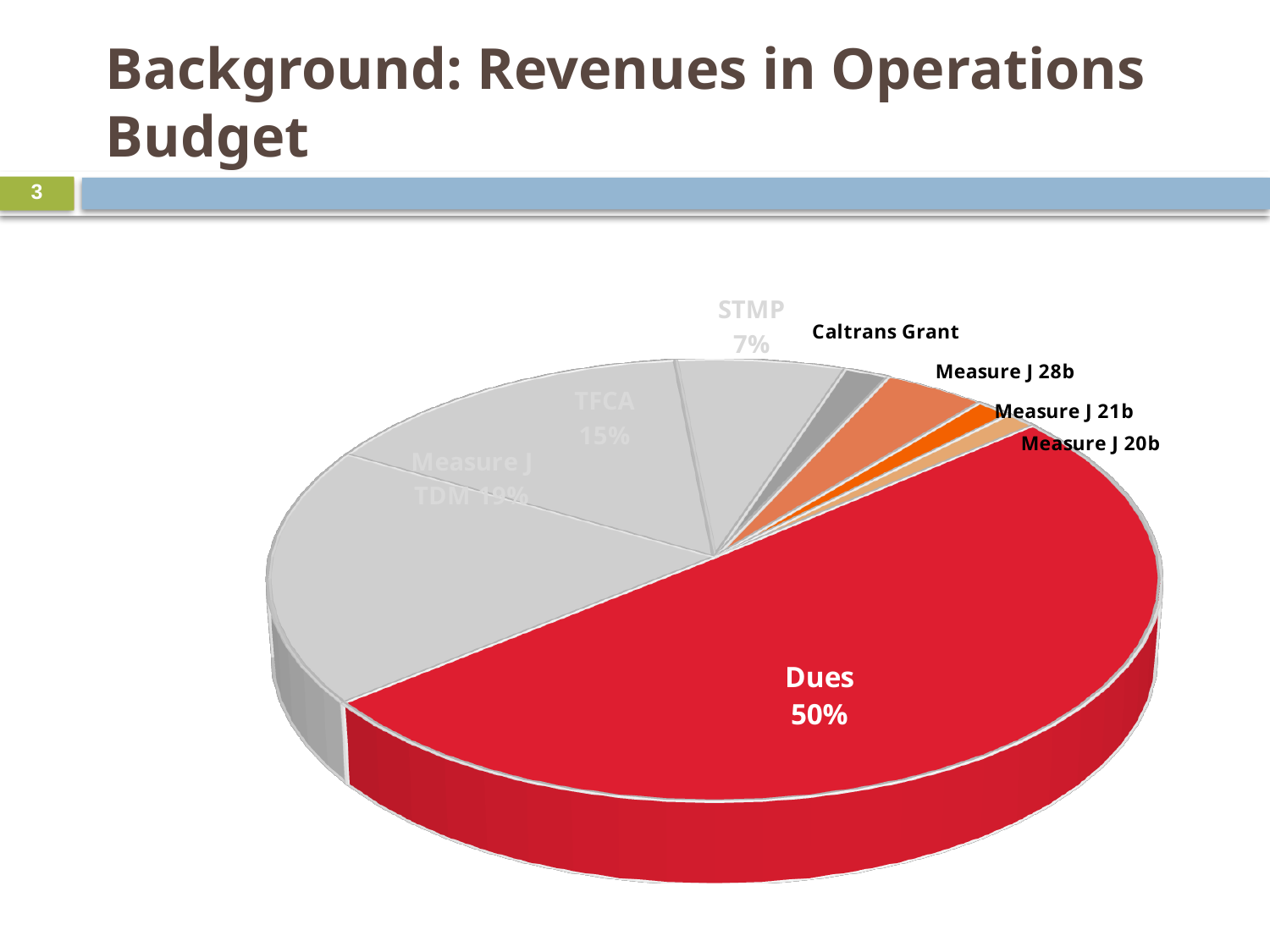
Which category has the largest slice of the pie? Dues What colour is the Dues slice? red What share of the pie does TFCA represent? 15% What kind of chart is shown on the slide? pie chart What is the difference in percentage points between the TFCA slice and the STMP slice? 8 How many slices does the pie chart have? 8 What share of the pie does Dues represent? 50% Which slice is larger, STMP or Caltrans Grant? STMP What is the difference in percentage points between the Dues slice and the Measure J TDM slice? 31 What share of the pie does Measure J TDM represent? 19% Which slice is larger, Measure J TDM or TFCA? Measure J TDM